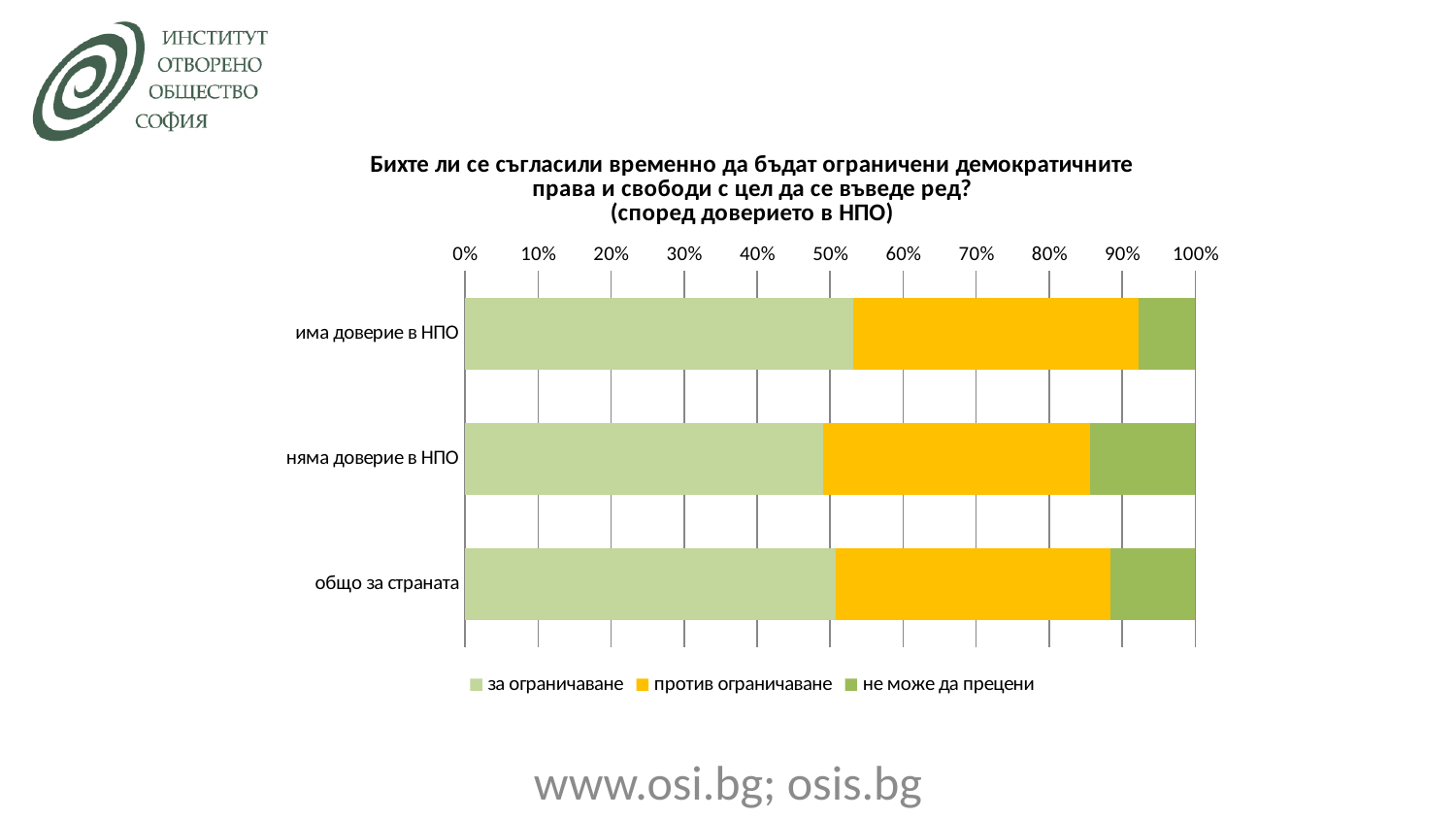
Is the value for "за ограничаване" in the "има доверие в НПО" bar greater or less than 50%? greater Which category has the smallest share for "не може да прецени"? има доверие в НПО How many categories are shown on the vertical axis of the chart? 3 Is the value for "за ограничаване" in the "няма доверие в НПО" bar greater or less than 40%? greater What kind of chart is shown on the slide? stacked bar chart Which category has the largest share for "за ограничаване"? има доверие в НПО What is the last entry listed in the chart legend? не може да прецени Is the value for "не може да прецени" in the "има доверие в НПО" bar greater or less than 10%? less Which is larger: the "за ограничаване" share for "има доверие в НПО" or for "няма доверие в НПО"? има доверие в НПО What colour represents "против ограничаване" in the chart? yellow How many series does the legend list? 3